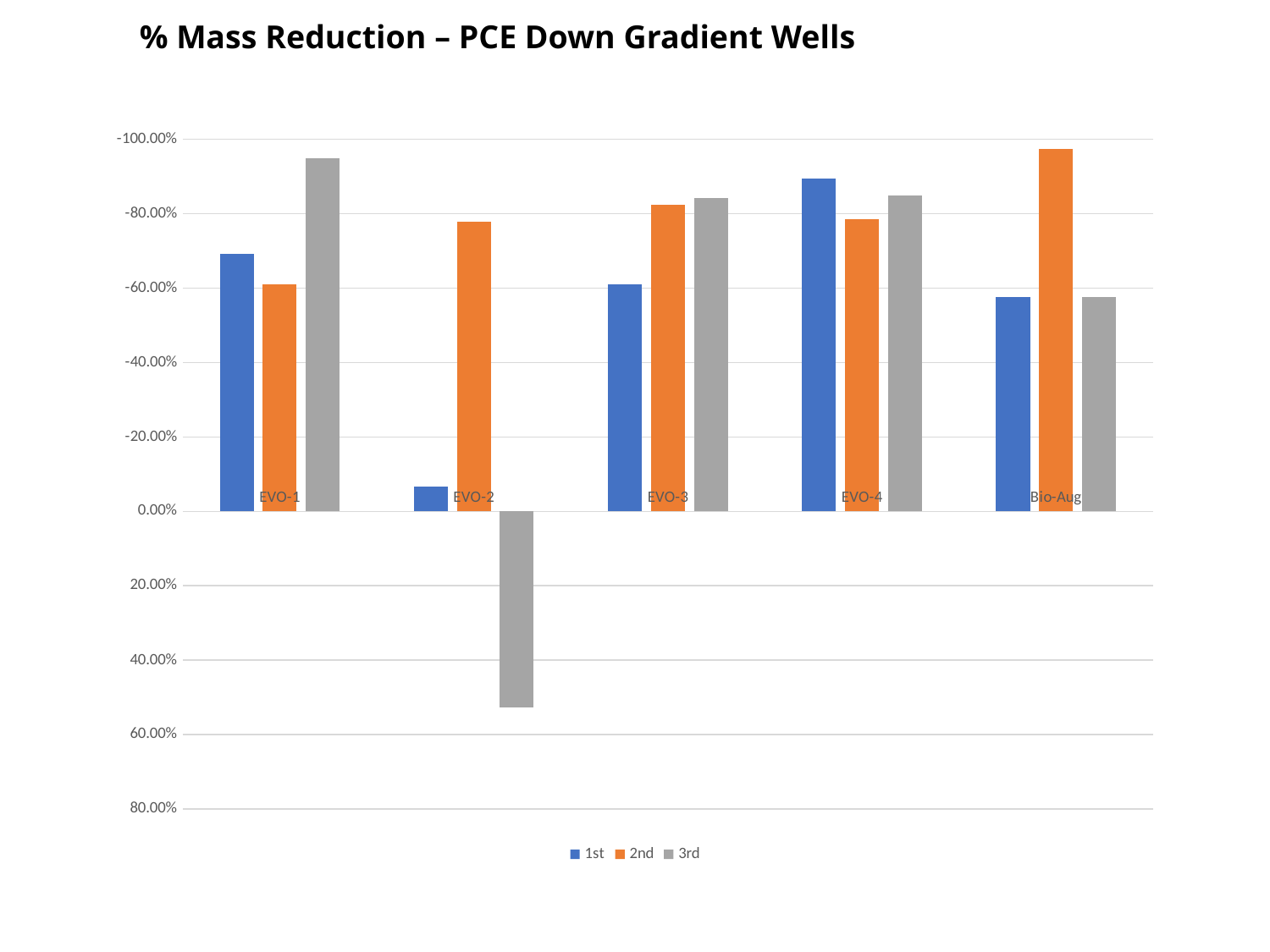
How many categories are shown on the x axis of the chart? 5 For Bio-Aug, which series has the bar reaching furthest toward -100.00%? 2nd Which category has a bar that extends below the 0.00% line into positive values? EVO-2 For EVO-4, which series has the bar reaching furthest toward -100.00%? 1st What is the title of the chart? % Mass Reduction – PCE Down Gradient Wells For EVO-1, which series has the bar reaching furthest toward -100.00%? 3rd What kind of chart is shown on the slide? bar chart Is the value for the 1st series at EVO-2 greater or less than -20.00%? greater How many series does the legend list? 3 Is the value for the 3rd series at EVO-2 greater or less than 40.00%? greater What are the series names listed in the legend? 1st, 2nd, 3rd